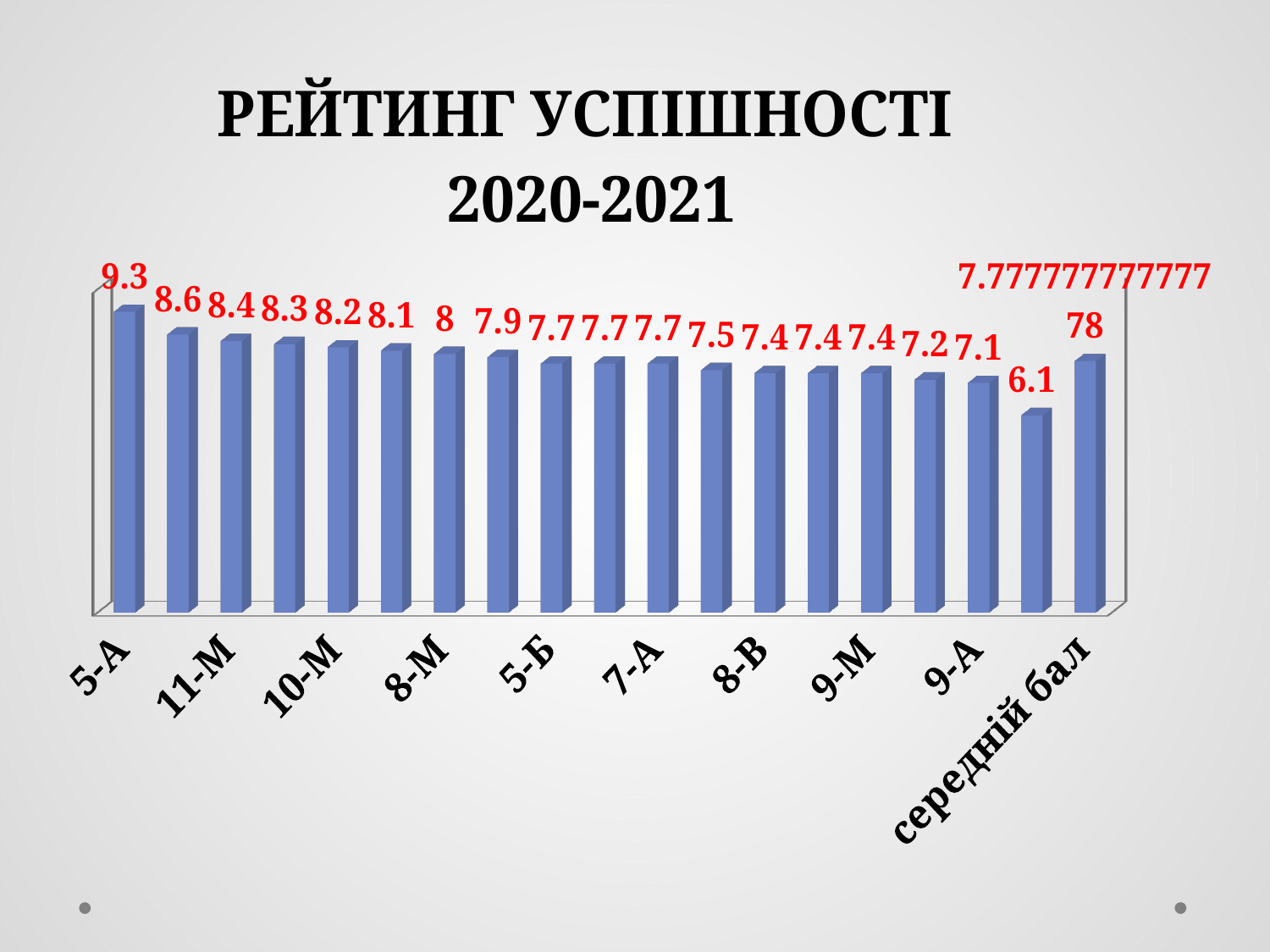
Which is larger, the value for 5-А or the value for 10-М? 5-А What is the difference between the values for 5-А and 9-А? 2.2 What kind of chart is shown on the slide? bar chart What is the value for середній бал? 7.77777777777778 How many bars are plotted on the chart? 19 What is the title of the slide? РЕЙТИНГ УСПІШНОСТІ 2020-2021 What is the value for 9-А? 7.1 What is the value for 5-А? 9.3 What is the lowest value shown on the chart? 6.1 Which category has the highest value? 5-А Do the class values rise or fall from left to right across the chart (before the final average bar)? fall What is the value for 11-М? 8.4